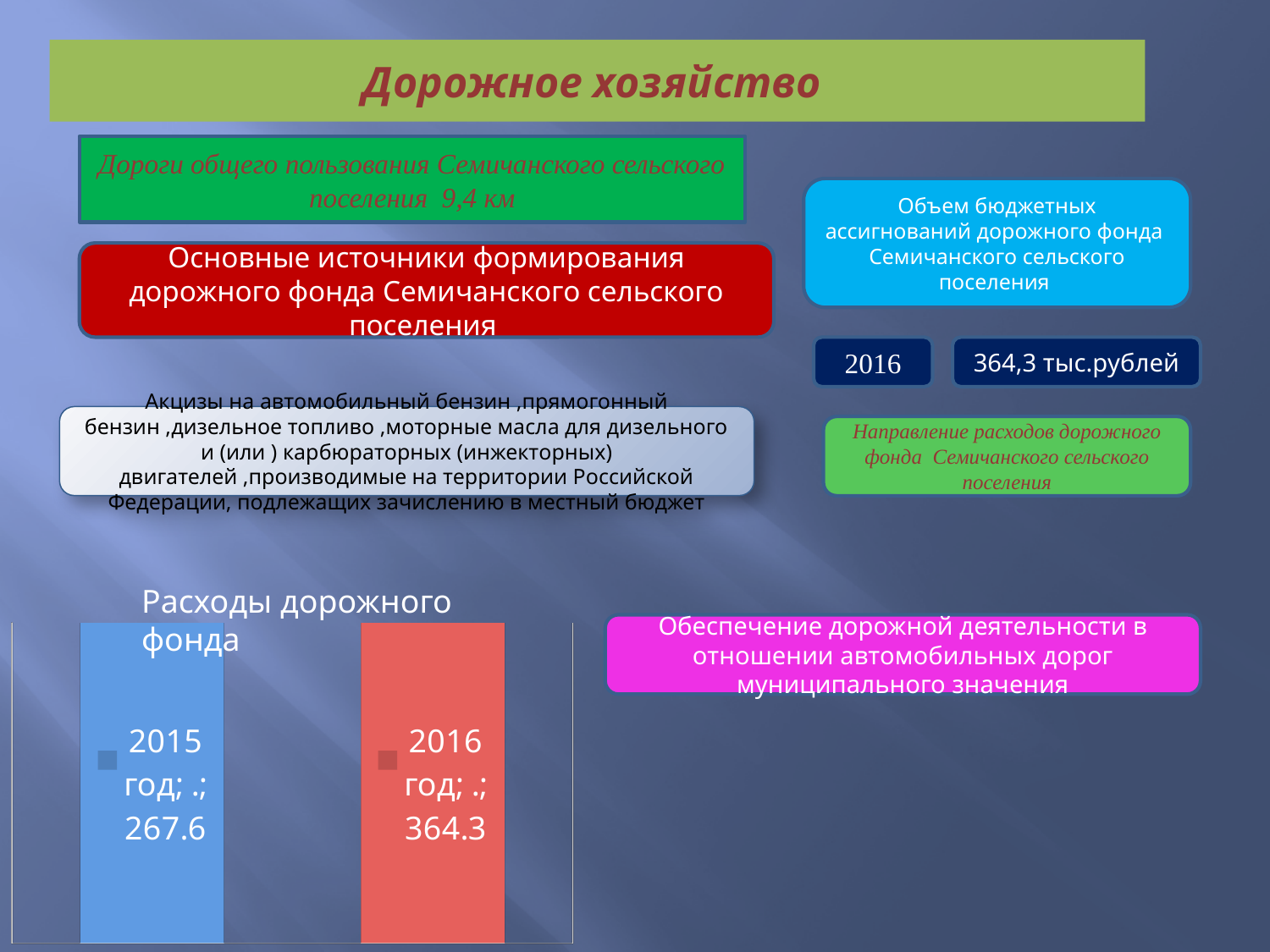
What kind of chart is 'Расходы дорожного фонда'? Bar chart What colour is the bar for 2016 год in the chart 'Расходы дорожного фонда'? Red What is the value for 2016 год in the chart 'Расходы дорожного фонда'? 364.3 How many bars are shown in the chart 'Расходы дорожного фонда'? 2 Which year has the lowest value in the chart 'Расходы дорожного фонда'? 2015 год What is the value for 2015 год in the chart 'Расходы дорожного фонда'? 267.6 What is the difference between the 2016 год and 2015 год values in the chart 'Расходы дорожного фонда'? 96.7 Do the values in the chart 'Расходы дорожного фонда' rise or fall from 2015 год to 2016 год? Rise Which year has the highest value in the chart 'Расходы дорожного фонда'? 2016 год In the chart 'Расходы дорожного фонда', is the value for 2015 год or 2016 год larger? 2016 год What is the title of the chart on the slide? Расходы дорожного фонда